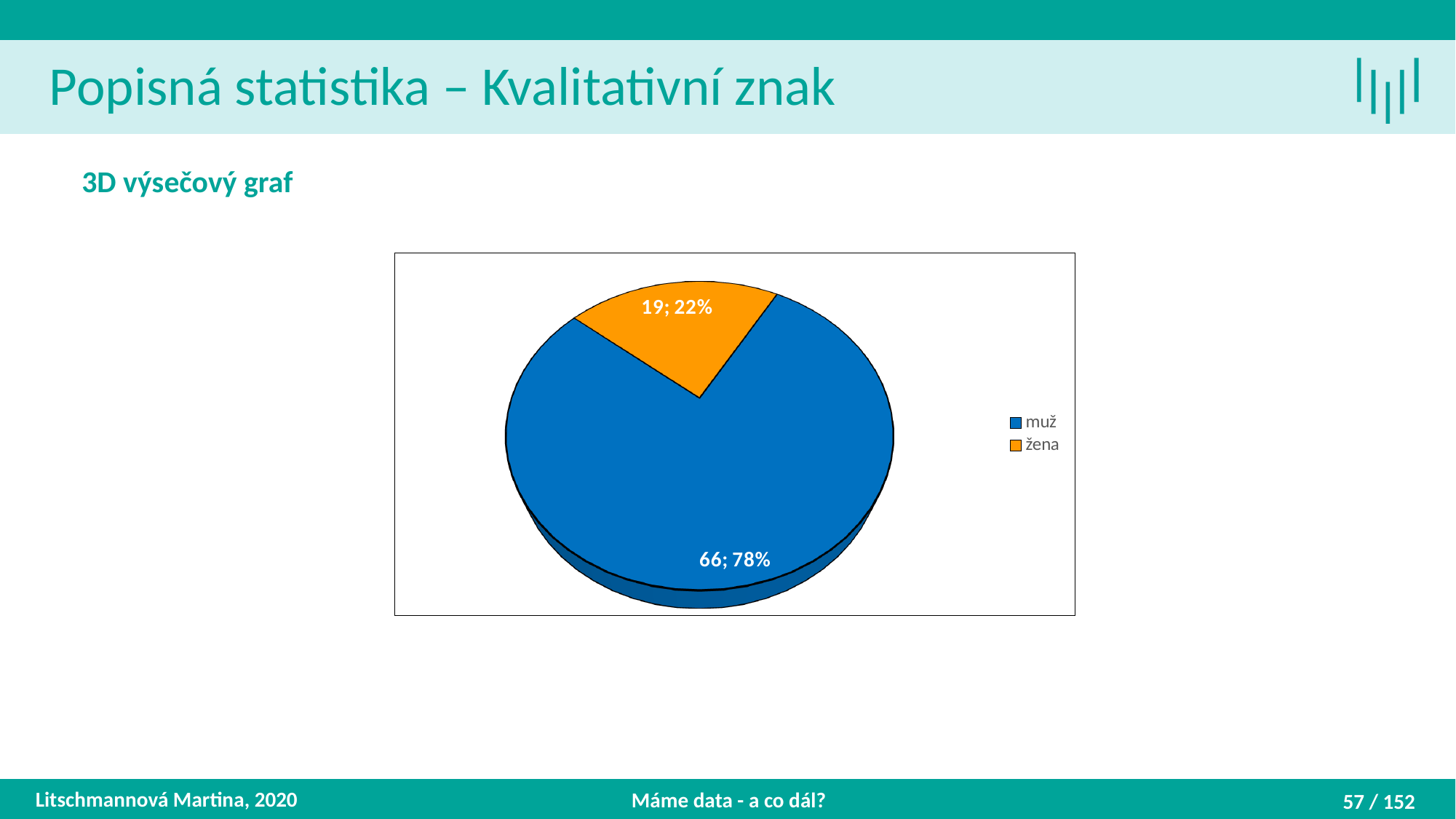
What is the total count across both slices? 85 How many entries does the legend list? 2 What colour is the žena slice? orange What share of the pie does the žena slice represent? 22% How many slices does the pie chart have? 2 Which category has the largest slice? muž What is the count shown for the žena slice? 19 What share of the pie does the muž slice represent? 78% Which category has the smallest slice? žena What is the count shown for the muž slice? 66 What is the difference between the counts for muž and žena? 47 What kind of chart is shown on the slide? pie chart